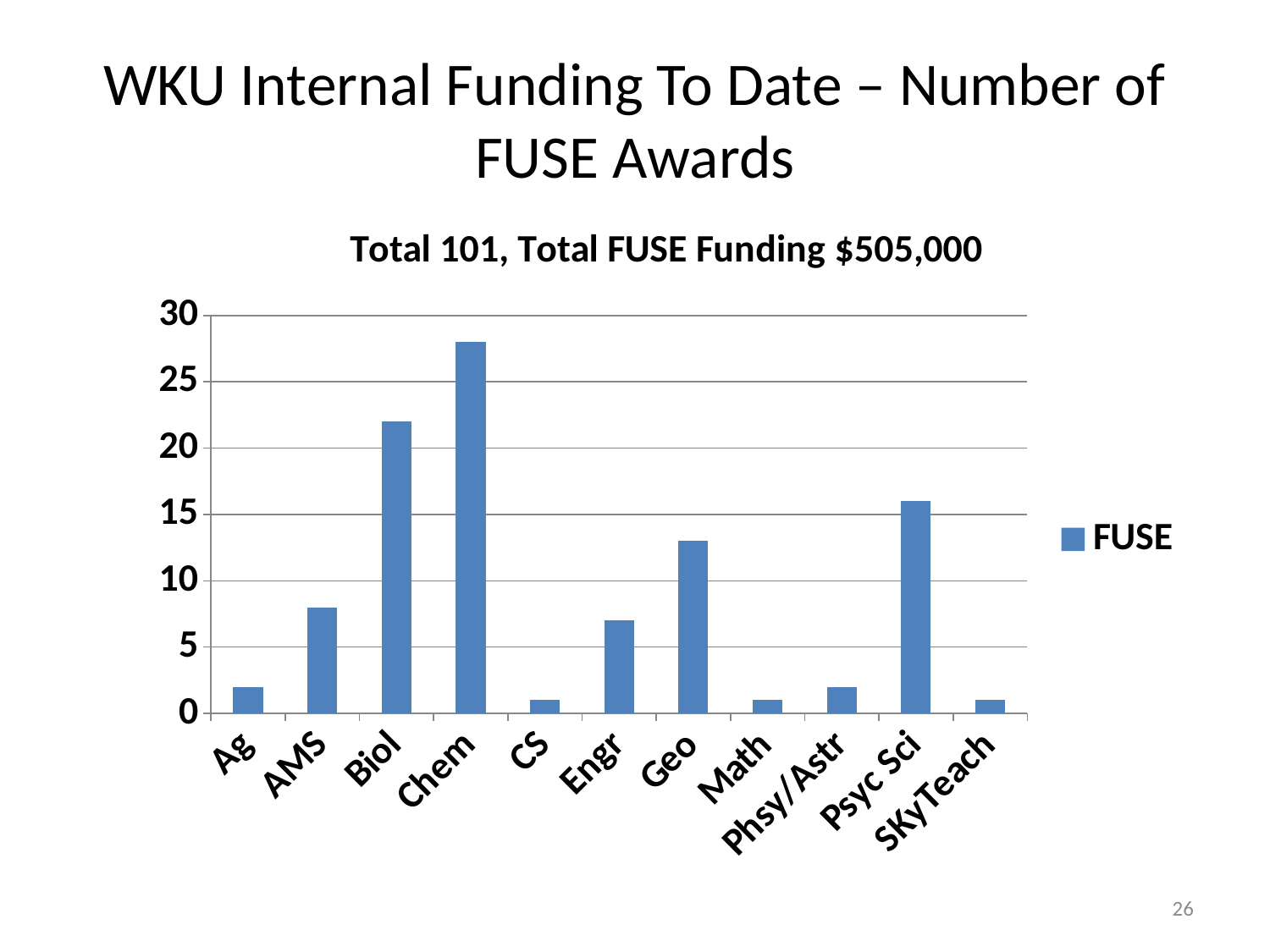
What kind of chart is shown on the slide? bar chart What is the title of the chart? Total 101, Total FUSE Funding $505,000 Is the value for AMS greater or less than 10? less How many departments are shown on the x axis of the chart? 11 Is the value for Biol greater or less than 20? greater Is the value for Psyc Sci greater or less than 15? greater How many series does the legend list? 1 Which has more FUSE awards, Biol or Geo? Biol Which has more FUSE awards, Engr or Psyc Sci? Psyc Sci Which department has the highest number of FUSE awards? Chem